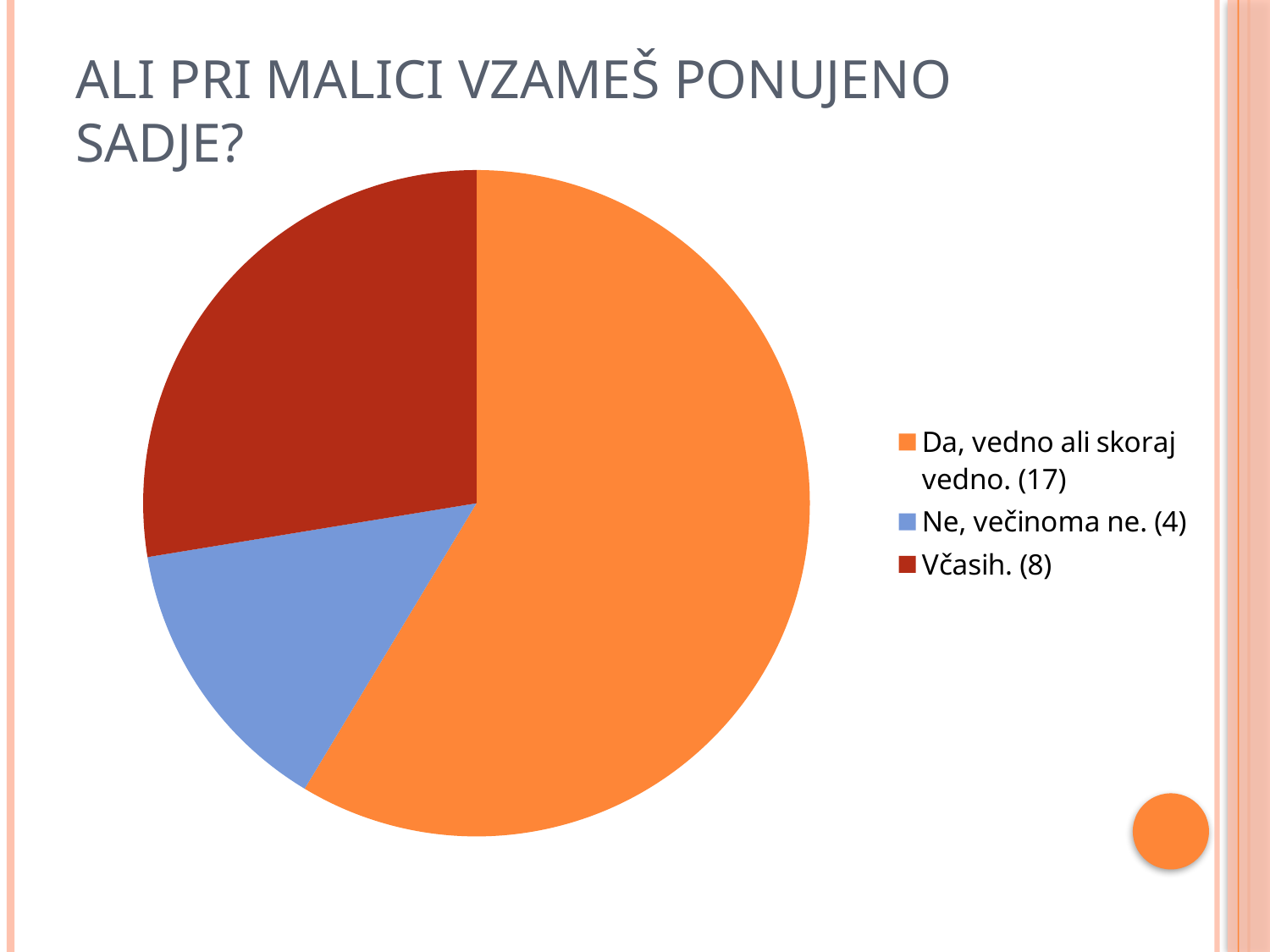
What kind of chart is shown on the slide? Pie chart How many respondents answered "Da, vedno ali skoraj vedno."? 17 What is the difference between the number of "Da, vedno ali skoraj vedno." responses and "Včasih." responses? 9 How many respondents answered "Včasih."? 8 What is the total number of responses shown in the pie chart? 29 What is the difference between the number of "Včasih." responses and "Ne, večinoma ne." responses? 4 Which answer has the largest slice of the pie? Da, vedno ali skoraj vedno. Which answer has the smallest slice of the pie? Ne, večinoma ne. What colour is the slice for "Ne, večinoma ne."? Blue How many respondents answered "Ne, večinoma ne."? 4 How many slices does the pie chart have? 3 Which has more responses, "Včasih." or "Ne, večinoma ne."? Včasih.